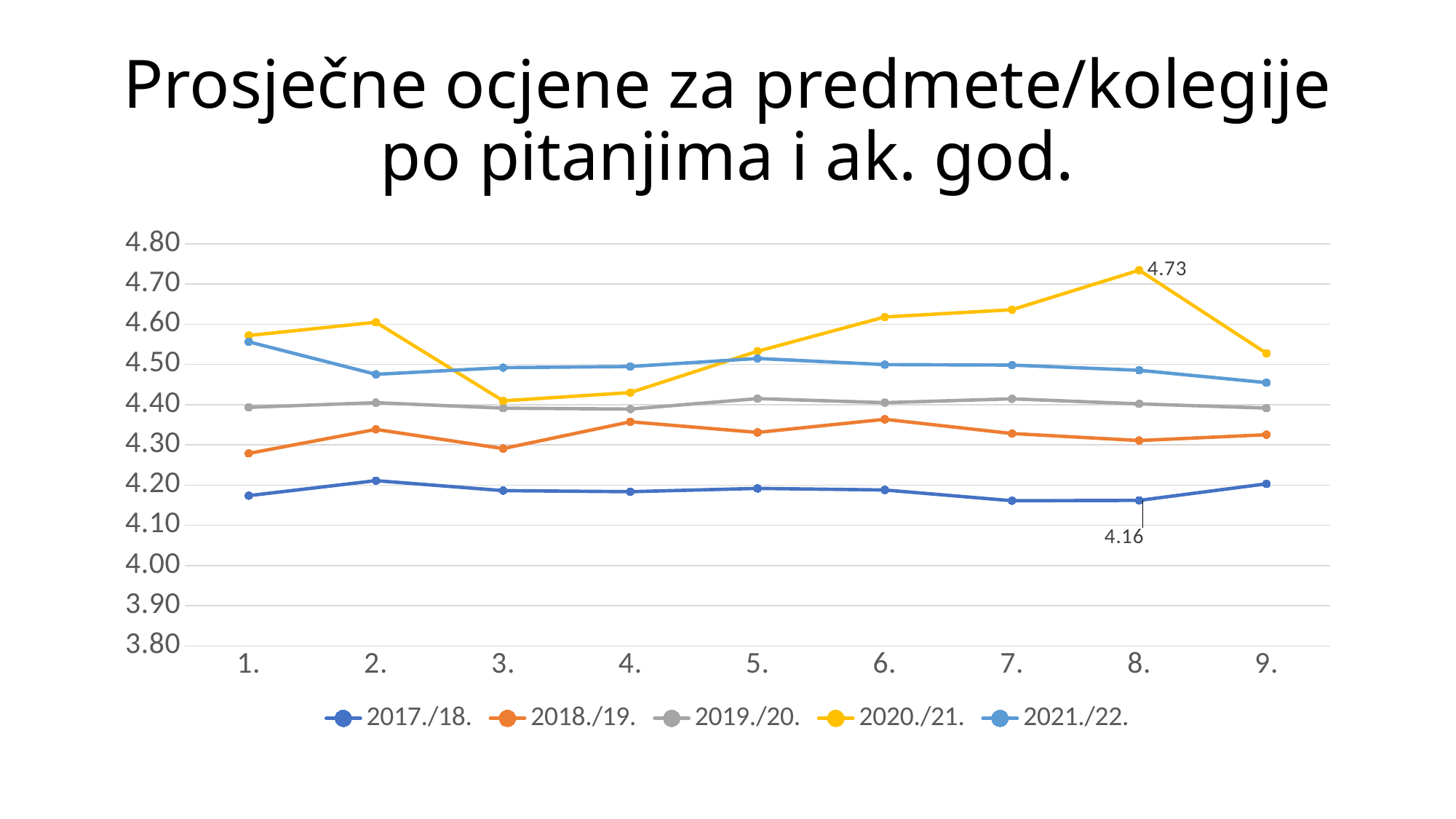
Which series has the lowest value at category 1.? 2017./18. What is the value for the 2020./21. series at category 8.? 4.73 What is the difference between the 2020./21. value and the 2017./18. value at category 8.? 0.57 How many series does the legend list? 5 Is the value for the 2017./18. series at category 7. greater or less than 4.20? less Is the value for the 2018./19. series at category 6. greater or less than 4.30? greater What kind of chart is shown on the slide? line chart At category 2., which series has the larger value: 2020./21. or 2021./22.? 2020./21. Which series has the highest value at category 8.? 2020./21. At which category does the 2020./21. series reach its highest value? 8. How many categories are shown on the x axis? 9 What is the value for the 2017./18. series at category 8.? 4.16